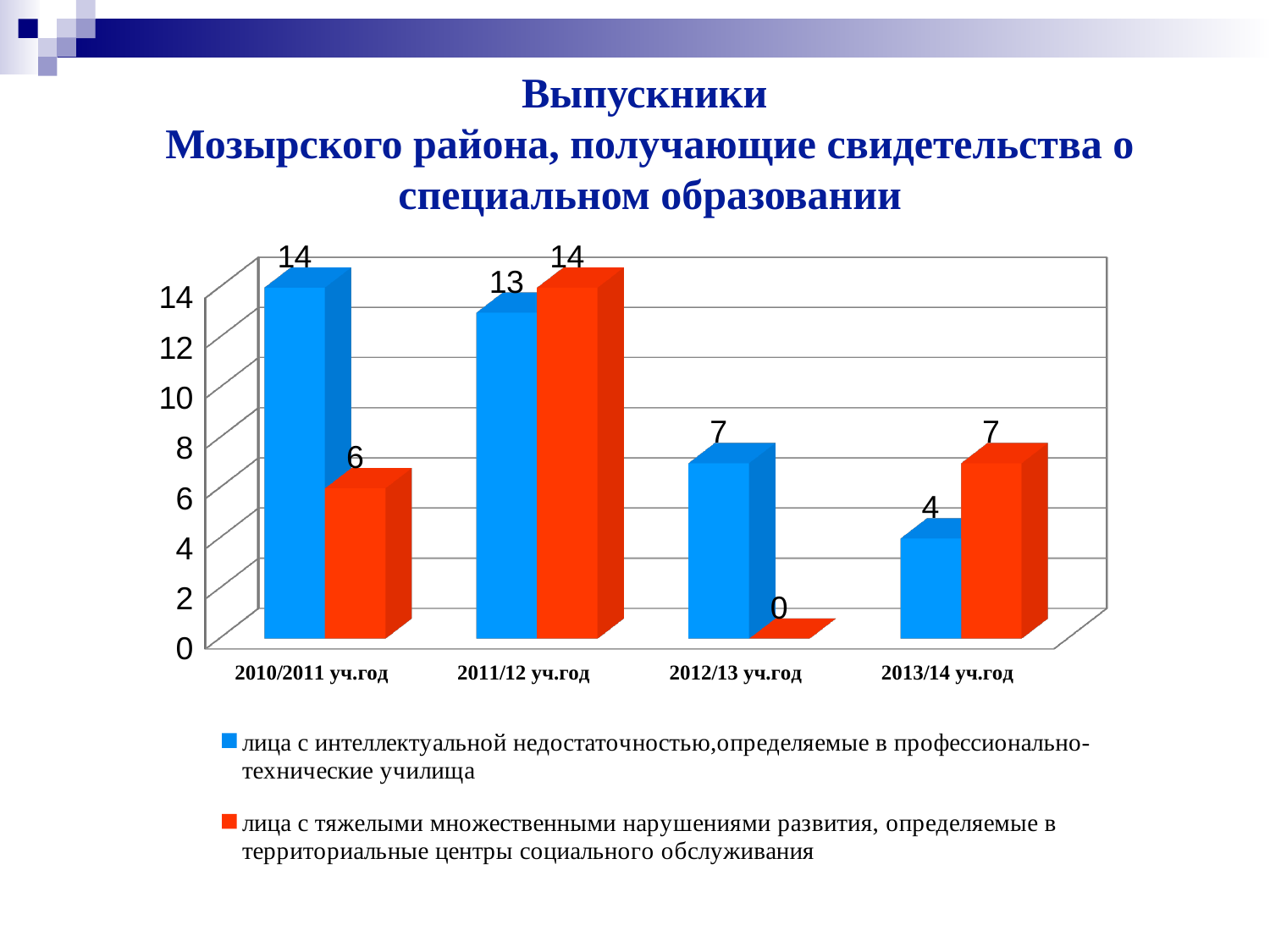
How many series does the legend list? 2 In which year is the blue series (лица с интеллектуальной недостаточностью) lowest? 2013/14 уч.год What is the difference between the blue and red values in 2010/2011 уч.год? 8 How many academic years are shown on the x axis? 4 Does the blue series rise or fall from 2011/12 уч.год to 2013/14 уч.год? fall What kind of chart is shown on the slide? bar chart What is the total of the blue and red values in 2011/12 уч.год? 27 What is the value for the red series in 2012/13 уч.год? 0 What is the value for the red series (лица с тяжелыми множественными нарушениями развития) in 2013/14 уч.год? 7 What is the value for the blue series (лица с интеллектуальной недостаточностью) in 2010/2011 уч.год? 14 Which series has the larger value in 2013/14 уч.год, blue or red? red In which year is the red series (лица с тяжелыми множественными нарушениями развития) highest? 2011/12 уч.год